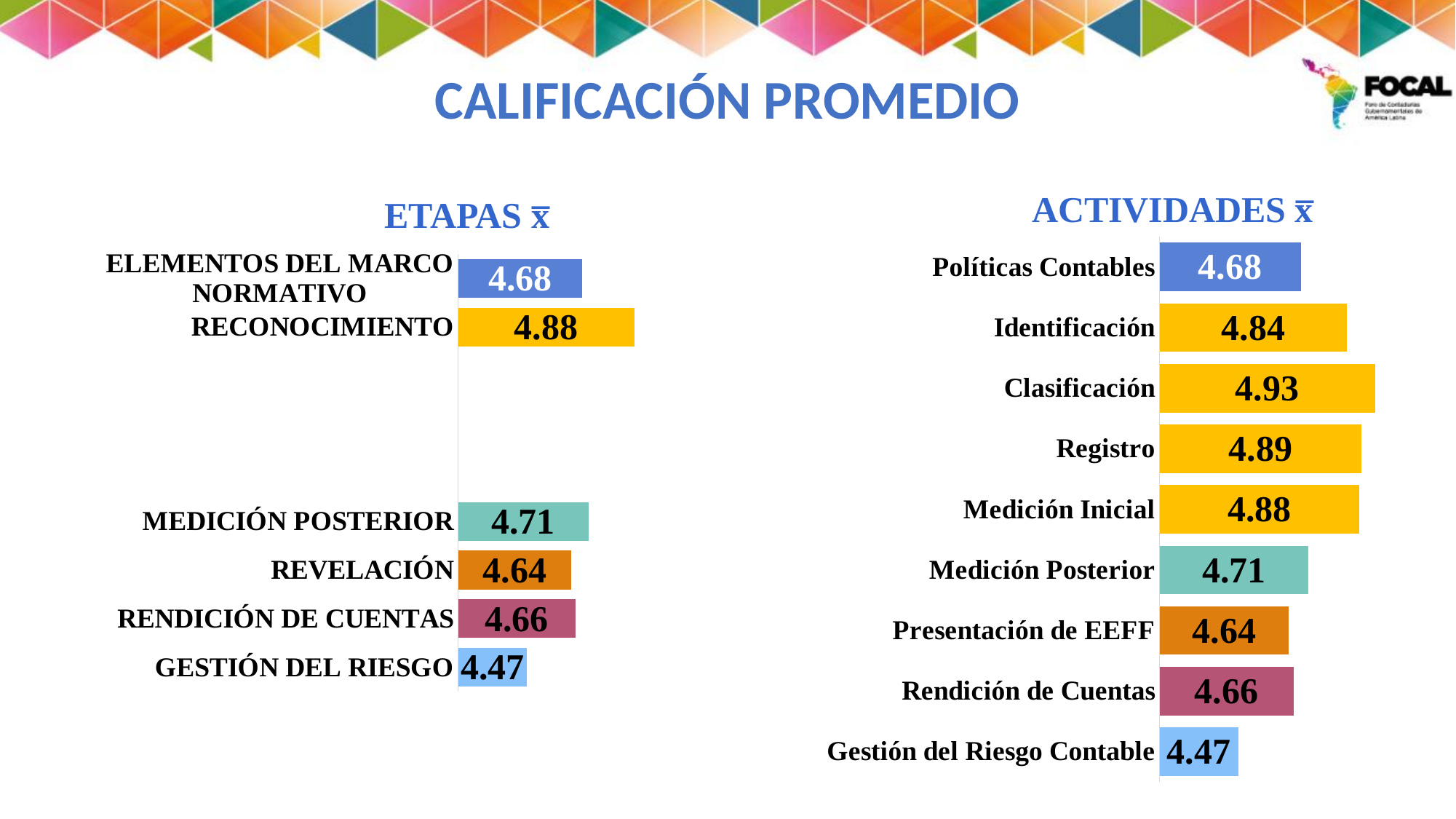
In the ETAPAS chart, what is the value for RECONOCIMIENTO? 4.88 In the ACTIVIDADES chart, what is the value for Registro? 4.89 In the ACTIVIDADES chart, what is the value for Presentación de EEFF? 4.64 In the ETAPAS chart, what is the difference between RECONOCIMIENTO and REVELACIÓN? 0.24 In the ACTIVIDADES chart, how many activities are shown? 9 In the ETAPAS chart, what is the value for GESTIÓN DEL RIESGO? 4.47 In the ACTIVIDADES chart, which activity has the lowest value? Gestión del Riesgo Contable In the ACTIVIDADES chart, what is the difference between Clasificación and Gestión del Riesgo Contable? 0.46 What type of chart is the ACTIVIDADES chart? Bar chart In the ETAPAS chart, which category has the highest value? RECONOCIMIENTO In the ETAPAS chart, which category has the lowest value? GESTIÓN DEL RIESGO In the ACTIVIDADES chart, which activity has the highest value? Clasificación